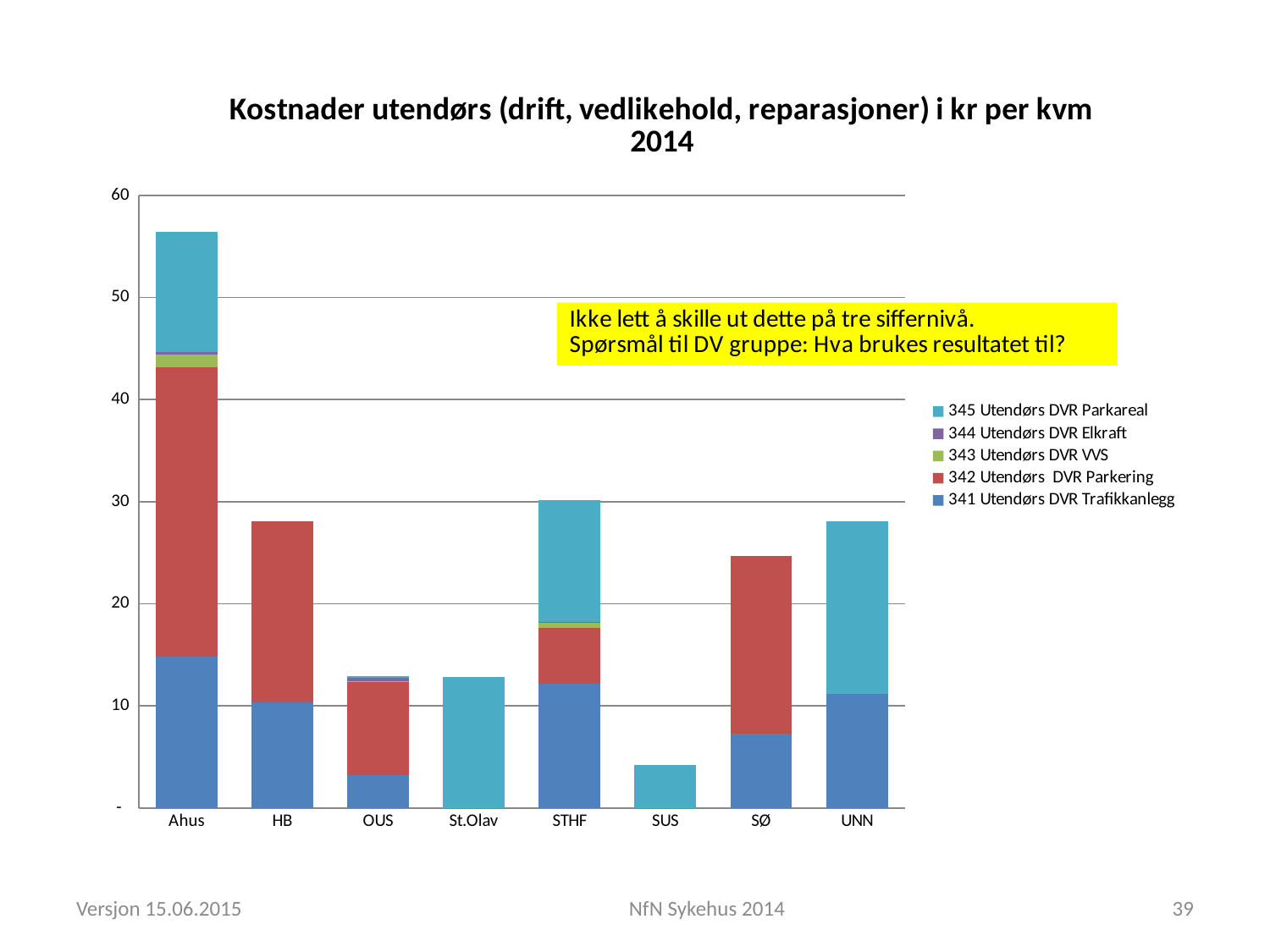
Which has the larger total bar, Ahus or HB? Ahus Which has the larger total bar, STHF or OUS? STHF Is the total value for Ahus greater or less than 50? greater Is the 341 Utendørs DVR Trafikkanlegg value for Ahus greater or less than 10? greater Is the total value for SUS greater or less than 10? less Which hospital has the highest total stacked bar? Ahus What kind of chart is shown on the slide? Stacked bar chart How many hospitals (categories) are shown on the x axis? 8 How many series does the legend list? 5 Which hospital has the lowest total stacked bar? SUS Which legend series is shown in red? 342 Utendørs DVR Parkering